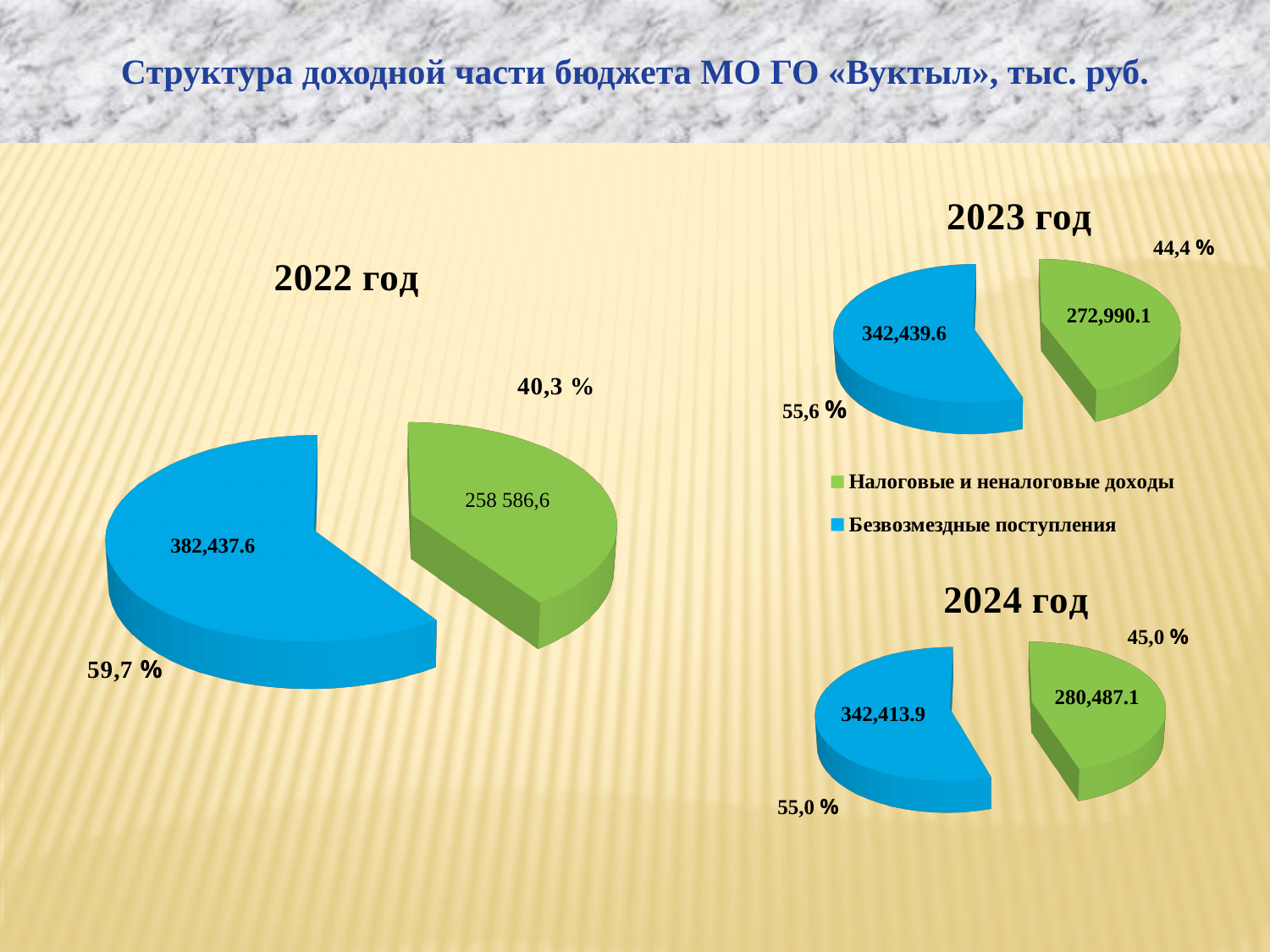
In the 2023 год chart, what share of the pie is Налоговые и неналоговые доходы? 44,4 % In the 2023 год chart, what is the value for Налоговые и неналоговые доходы? 272,990.1 In the 2024 год chart, what is the value for Безвозмездные поступления? 342,413.9 In the 2023 год chart, what is the difference between Безвозмездные поступления and Налоговые и неналоговые доходы? 69,449.5 Which colour represents Безвозмездные поступления in the charts? blue What type of chart is used for the 2022 год chart? pie chart How many series does the legend list? 2 In the 2022 год chart, what is the value for Безвозмездные поступления? 382,437.6 In the 2022 год chart, what is the value for Налоговые и неналоговые доходы? 258 586,6 In the 2024 год chart, which category is the largest? Безвозмездные поступления In the 2022 год chart, what share of the pie is Безвозмездные поступления? 59,7 % In the 2024 год chart, what share of the pie is Налоговые и неналоговые доходы? 45,0 %